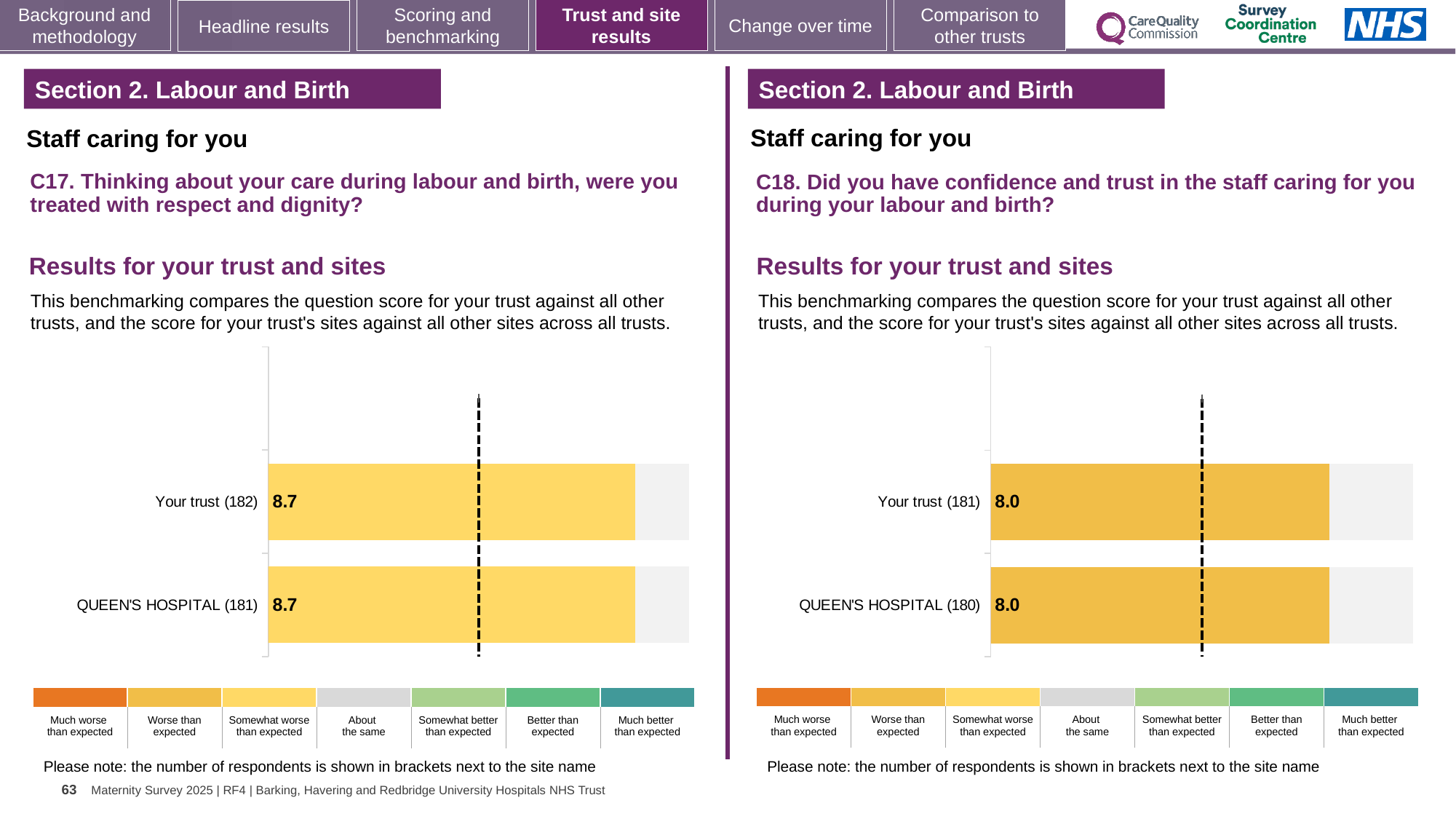
In the C18 chart on the right, what is the score for QUEEN'S HOSPITAL? 8.0 In the C17 chart on the left, how many respondents are shown in brackets for Your trust? 182 How many categories does the colour key below the C18 chart on the right list? 7 What type of chart is used for the C17 results on the left? Bar chart How many bars are plotted in the C18 chart on the right? 2 In the C18 chart on the right, what is the difference between the Your trust score and the QUEEN'S HOSPITAL score? 0.0 In the C17 chart on the left, what is the score for QUEEN'S HOSPITAL? 8.7 In the C17 chart on the left, what is the score for Your trust? 8.7 How many bars are plotted in the C17 chart on the left? 2 In the C18 chart on the right, how many respondents are shown in brackets for QUEEN'S HOSPITAL? 180 In the C18 chart on the right, what is the score for Your trust? 8.0 In the C17 chart on the left, what is the difference between the Your trust score and the QUEEN'S HOSPITAL score? 0.0